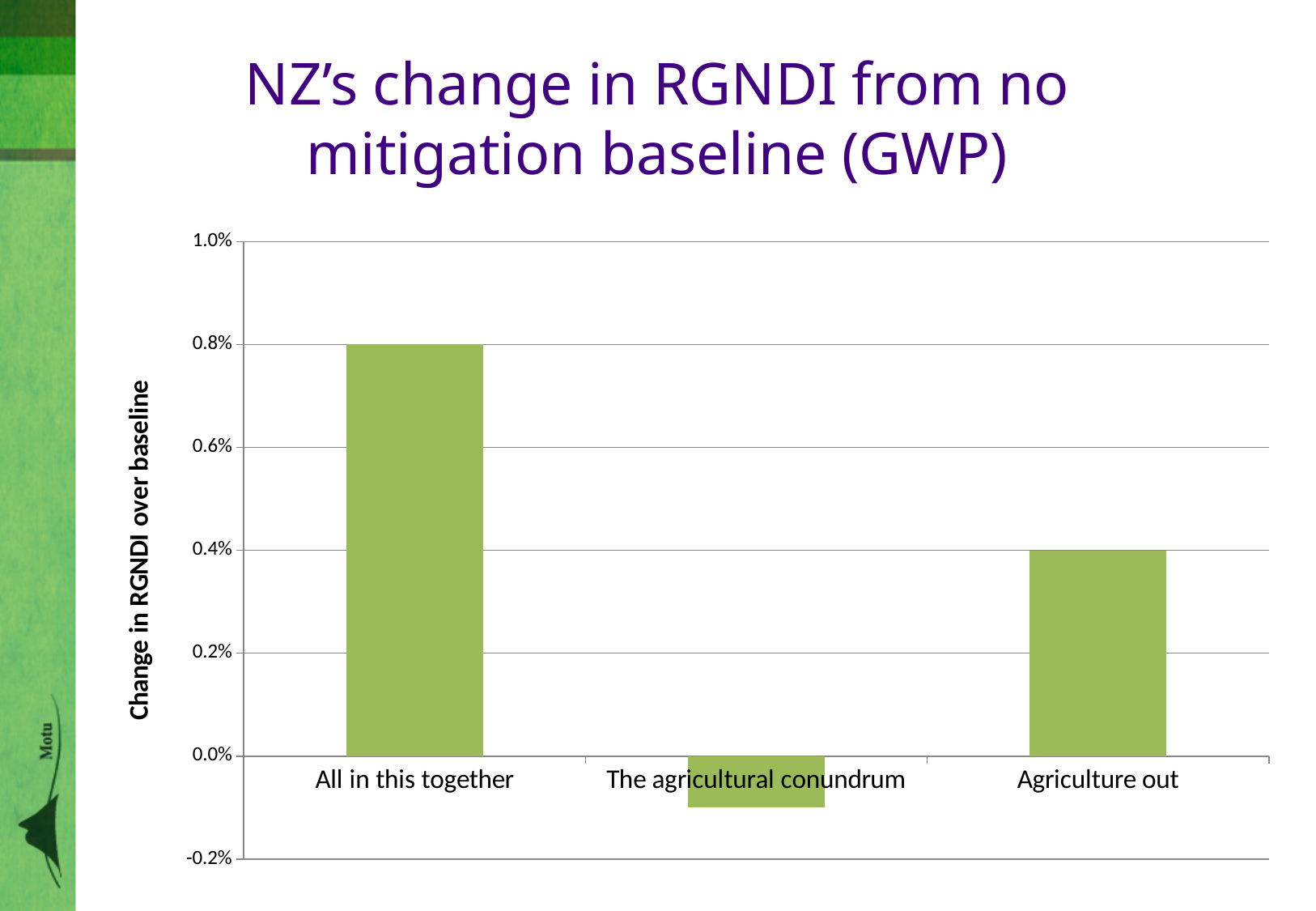
What is the title of the chart on the slide? NZ's change in RGNDI from no mitigation baseline (GWP) Which is larger, the value for "All in this together" or the value for "Agriculture out"? All in this together Is the value for "The agricultural conundrum" greater or less than -0.2%? greater Is the value for "The agricultural conundrum" greater or less than 0.0%? less What is the label of the vertical axis? Change in RGNDI over baseline What is the value for "All in this together"? 0.8% Which category has the lowest change in RGNDI over baseline? The agricultural conundrum What is the difference between the values for "All in this together" and "Agriculture out"? 0.4% What is the value for "Agriculture out"? 0.4% What kind of chart is shown on the slide? bar chart Which category has the highest change in RGNDI over baseline? All in this together How many categories are shown on the x axis? 3